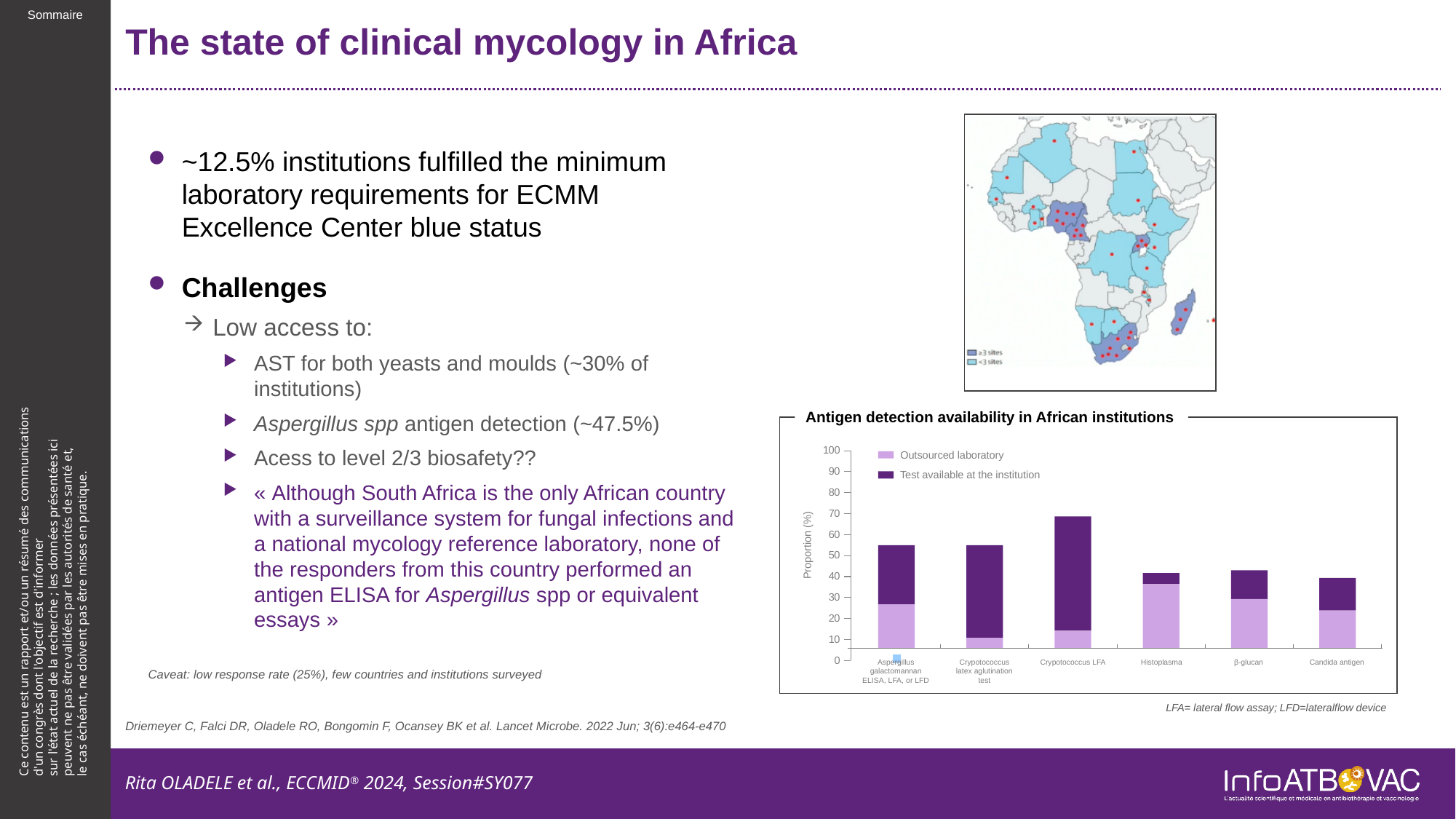
How many test categories are shown on the x axis of the 'Antigen detection availability in African institutions' chart? 6 In the 'Antigen detection availability in African institutions' chart, which test has the highest total proportion? Cryptococcus LFA In the 'Antigen detection availability in African institutions' chart, is the total proportion for Cryptococcus LFA greater or less than 60? greater In the 'Antigen detection availability in African institutions' chart, which has the larger 'Outsourced laboratory' proportion: Histoplasma or Cryptococcus latex aglutination test? Histoplasma In the 'Antigen detection availability in African institutions' chart, is the total proportion for Histoplasma greater or less than 50? less How many series does the legend of the 'Antigen detection availability in African institutions' chart list? 2 In the 'Antigen detection availability in African institutions' chart, is the total proportion for Candida antigen greater or less than 50? less What are the two legend entries in the 'Antigen detection availability in African institutions' chart? Outsourced laboratory; Test available at the institution What is the y-axis label of the 'Antigen detection availability in African institutions' chart? Proportion (%) In the 'Antigen detection availability in African institutions' chart, which has the larger total proportion: Cryptococcus LFA or Histoplasma? Cryptococcus LFA What kind of chart is 'Antigen detection availability in African institutions'? Stacked bar chart